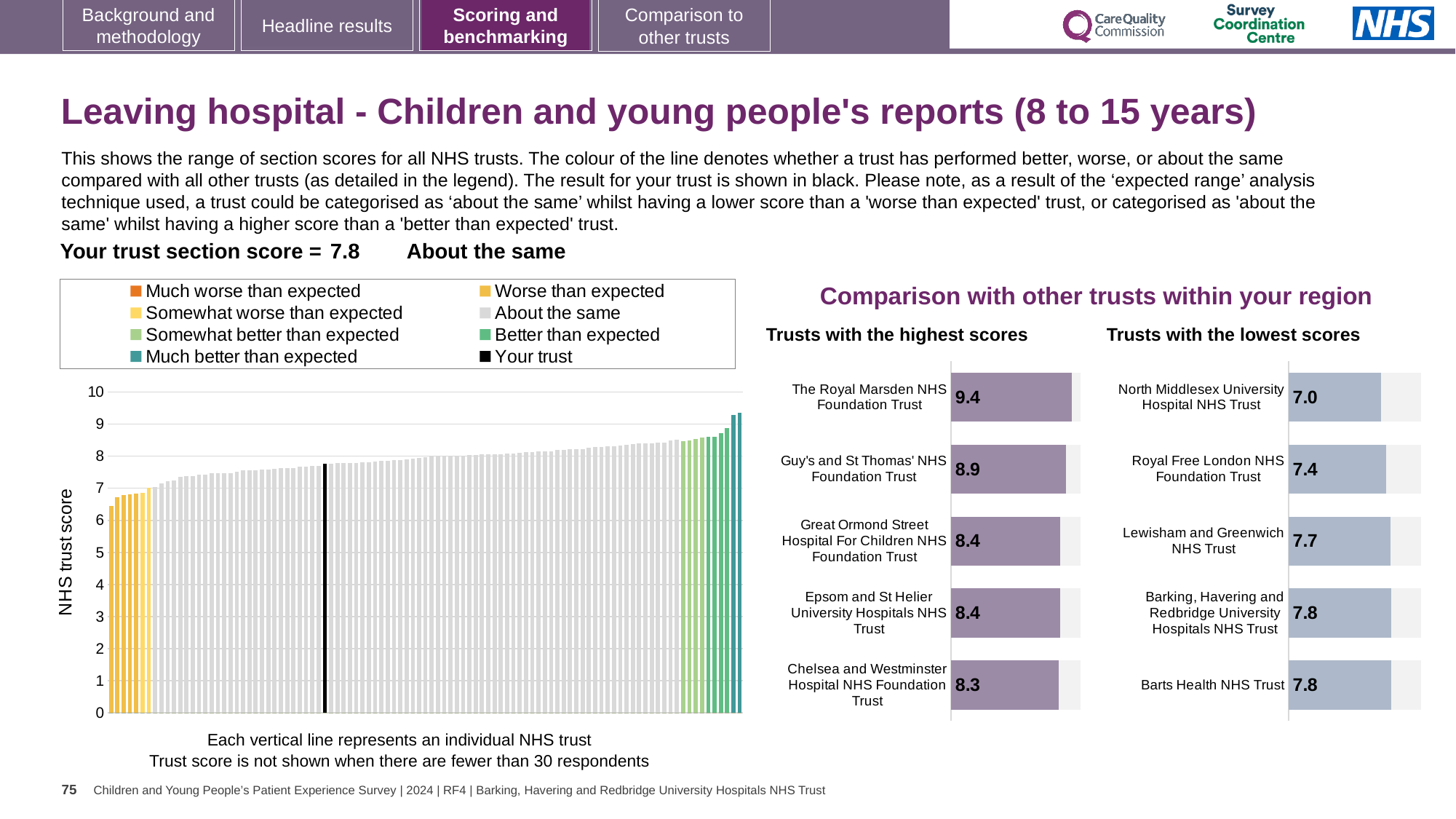
In the main chart on the left showing all NHS trusts, what is the section score for your trust (the black bar)? 7.8 In the 'Trusts with the highest scores' chart, what is the score for The Royal Marsden NHS Foundation Trust? 9.4 In the 'Trusts with the highest scores' chart, what is the difference between the scores of The Royal Marsden NHS Foundation Trust and Chelsea and Westminster Hospital NHS Foundation Trust? 1.1 In the 'Trusts with the highest scores' chart, which trust has the highest score? The Royal Marsden NHS Foundation Trust In the 'Trusts with the lowest scores' chart, what is the difference between the scores of Barking, Havering and Redbridge University Hospitals NHS Trust and North Middlesex University Hospital NHS Trust? 0.8 How many entries does the legend above the main chart on the left list? 8 In the main chart on the left showing all NHS trusts, do the values rise or fall from left to right? rise In the main chart on the left showing all NHS trusts, is the value of the tallest bar greater or less than 9? greater In the 'Trusts with the highest scores' chart, how many trusts are shown? 5 In the 'Trusts with the lowest scores' chart, which has the larger score: Royal Free London NHS Foundation Trust or Lewisham and Greenwich NHS Trust? Lewisham and Greenwich NHS Trust In the 'Trusts with the lowest scores' chart, what is the score for North Middlesex University Hospital NHS Trust? 7.0 In the 'Trusts with the lowest scores' chart, which trust has the lowest score? North Middlesex University Hospital NHS Trust